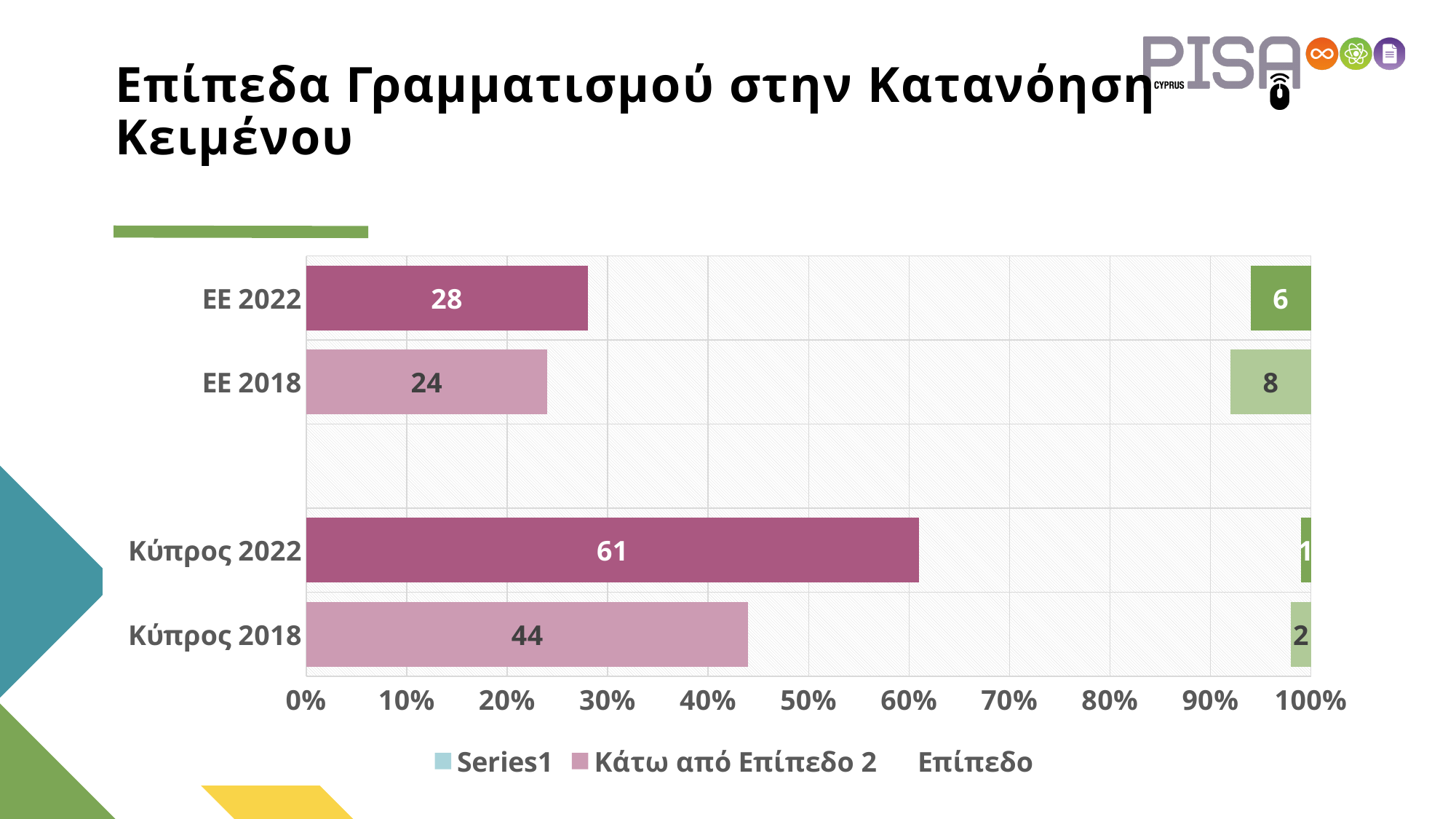
What is the value of the green bar for EE 2022? 6 What is the difference between the 'Κάτω από Επίπεδο 2' values for EE 2022 and EE 2018? 4 Which category has the highest 'Κάτω από Επίπεδο 2' value? Κύπρος 2022 What is the value of the 'Κάτω από Επίπεδο 2' bar for EE 2018? 24 Is the 'Κάτω από Επίπεδο 2' value for Κύπρος 2022 greater or less than 50%? greater What kind of chart is shown on the slide? bar chart What is the difference between the 'Κάτω από Επίπεδο 2' values for Κύπρος 2022 and Κύπρος 2018? 17 Which category has the lowest 'Κάτω από Επίπεδο 2' value? EE 2018 What is the value of the 'Κάτω από Επίπεδο 2' bar for Κύπρος 2022? 61 What is the value of the green bar for Κύπρος 2018? 2 How many categories are shown on the vertical axis of the chart? 4 Which has the larger green bar value, EE 2018 or EE 2022? EE 2018